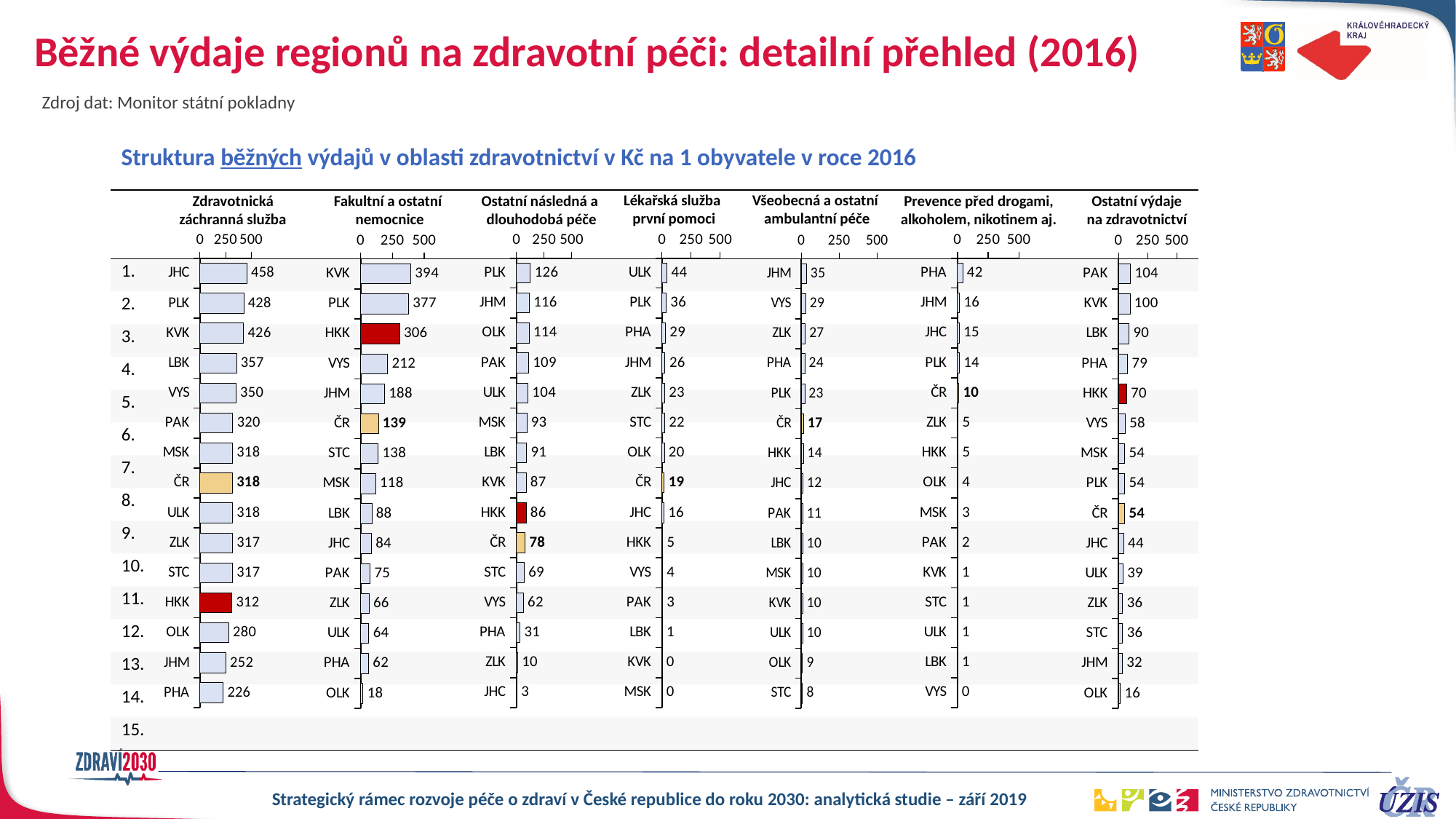
In the 'Ostatní výdaje na zdravotnictví' chart, what is the difference between PAK and OLK? 88 In the 'Fakultní a ostatní nemocnice' chart, which region's bar is coloured red? HKK In the 'Všeobecná a ostatní ambulantní péče' chart, which region has the lowest value? STC In the 'Lékařská služba první pomoci' chart, what is the value for ČR? 19 In the 'Zdravotnická záchranná služba' chart, what is the value for JHC? 458 In the 'Zdravotnická záchranná služba' chart, what is the difference between JHC and PHA? 232 How many bars are plotted in the 'Lékařská služba první pomoci' chart? 15 In the 'Fakultní a ostatní nemocnice' chart, what is the value for HKK? 306 In the 'Ostatní následná a dlouhodobá péče' chart, which region has the highest value? PLK What kind of chart is used for 'Ostatní výdaje na zdravotnictví'? Bar chart In the 'Fakultní a ostatní nemocnice' chart, which is larger, KVK or PLK? KVK In the 'Prevence před drogami, alkoholem, nikotinem aj.' chart, what is the value for PHA? 42